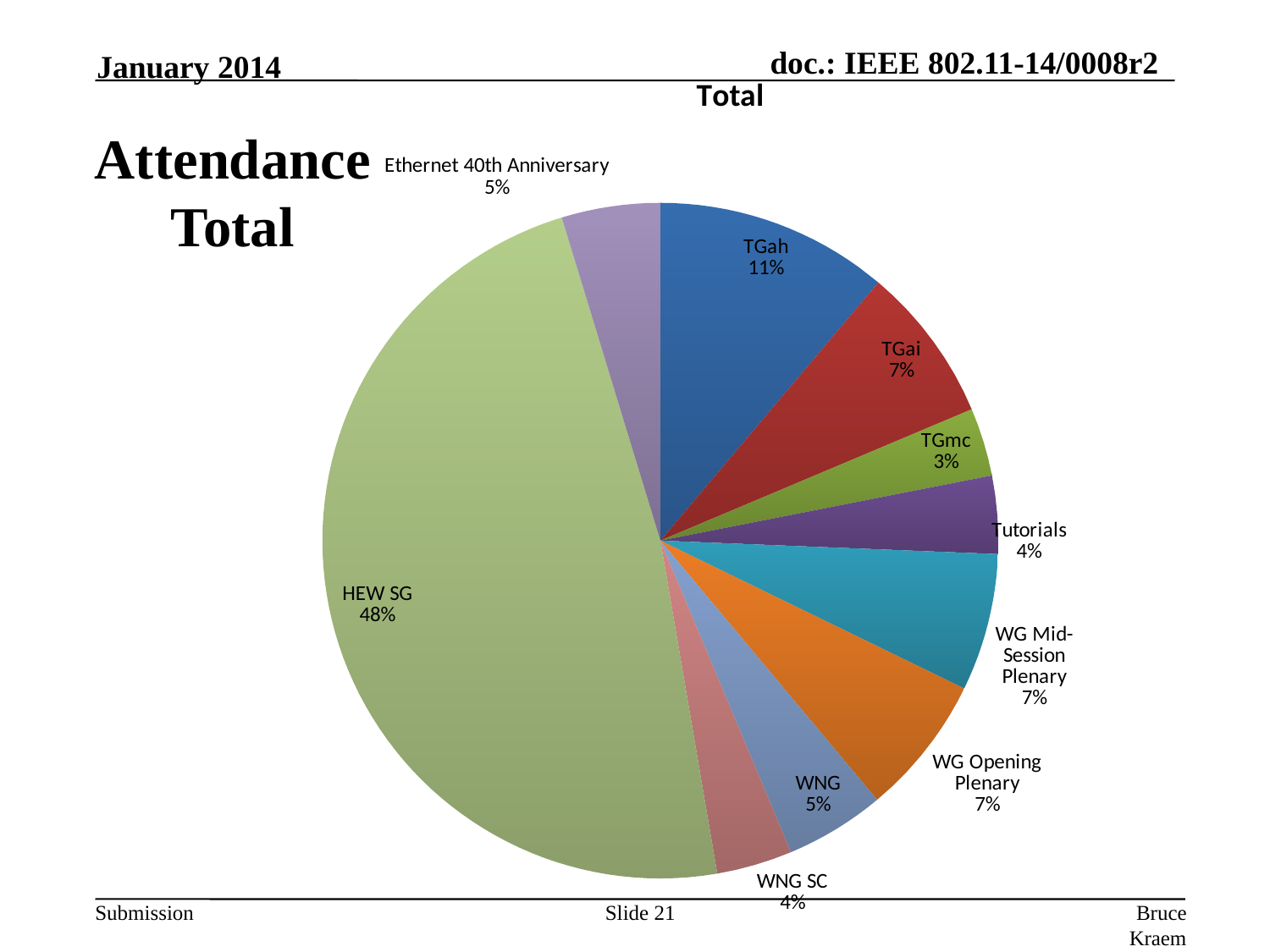
What is the difference in percentage points between HEW SG and TGah? 37 Which slice is the largest in the pie chart? HEW SG What percentage is shown for Ethernet 40th Anniversary? 5% What is the title of the pie chart? Total What percentage is shown for WG Mid-Session Plenary? 7% How many slices does the pie chart have? 10 What percentage is shown for TGmc? 3% What share of the pie does TGah have? 11% What share of the pie does HEW SG have? 48% Which slice is the smallest in the pie chart? TGmc Which is larger, the share for TGai or the share for Tutorials? TGai What kind of chart is shown on the slide? pie chart